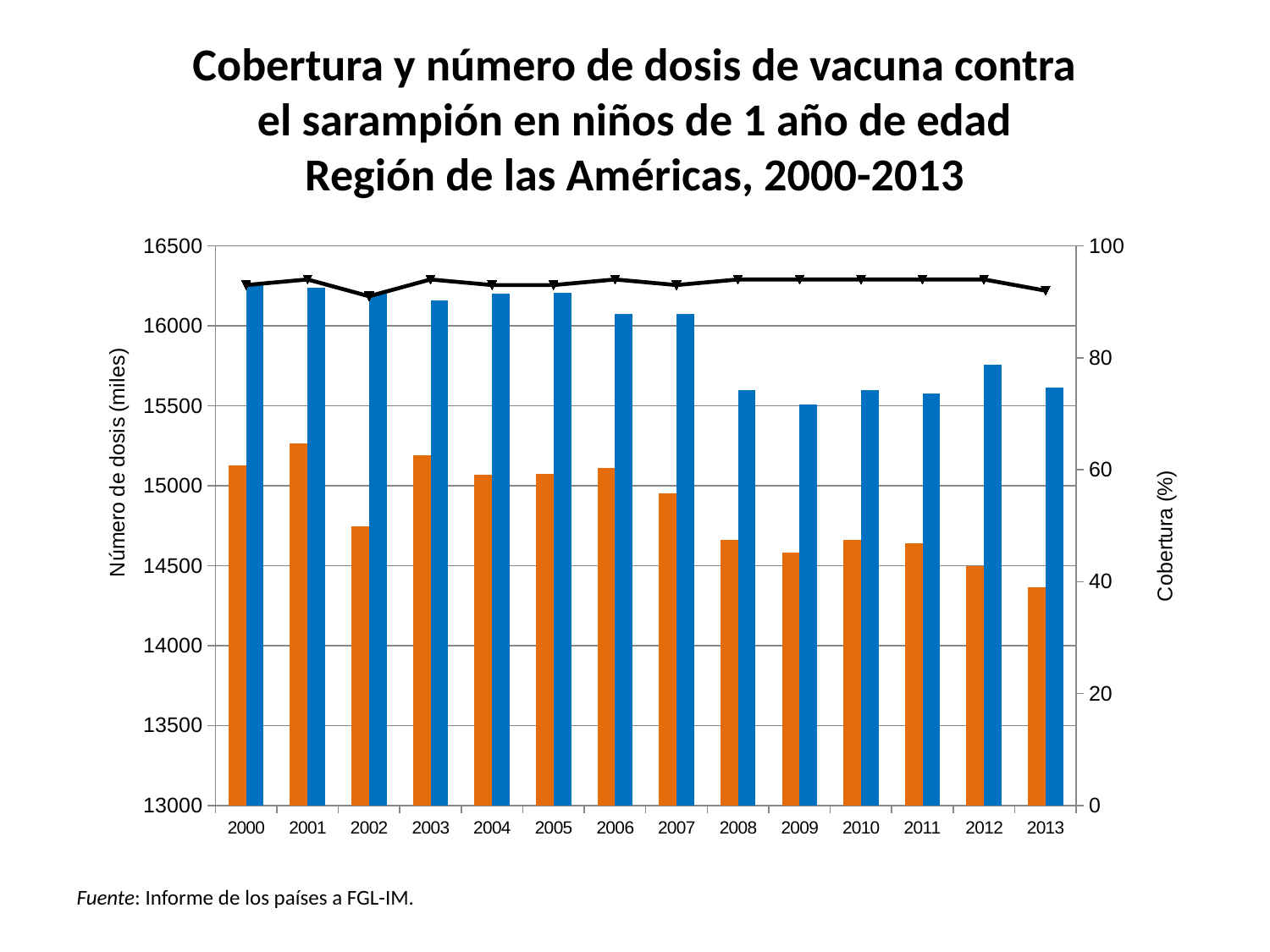
Is the value of the orange bar for 2013 greater or less than 14500? less What is the title of the left vertical axis? Número de dosis (miles) What kind of chart is shown on the slide? A bar chart combined with a line Which is larger, the blue bar for 2007 or the blue bar for 2008? 2007 In which year is the orange bar lowest? 2013 Do the orange bars generally rise or fall from 2000 to 2013? fall Is the value of the orange bar for 2002 greater or less than 15000? less Which is larger, the orange bar for 2001 or the orange bar for 2012? 2001 Is the value of the blue bar for 2008 greater or less than 16000? less How many years are shown along the x axis of the chart? 14